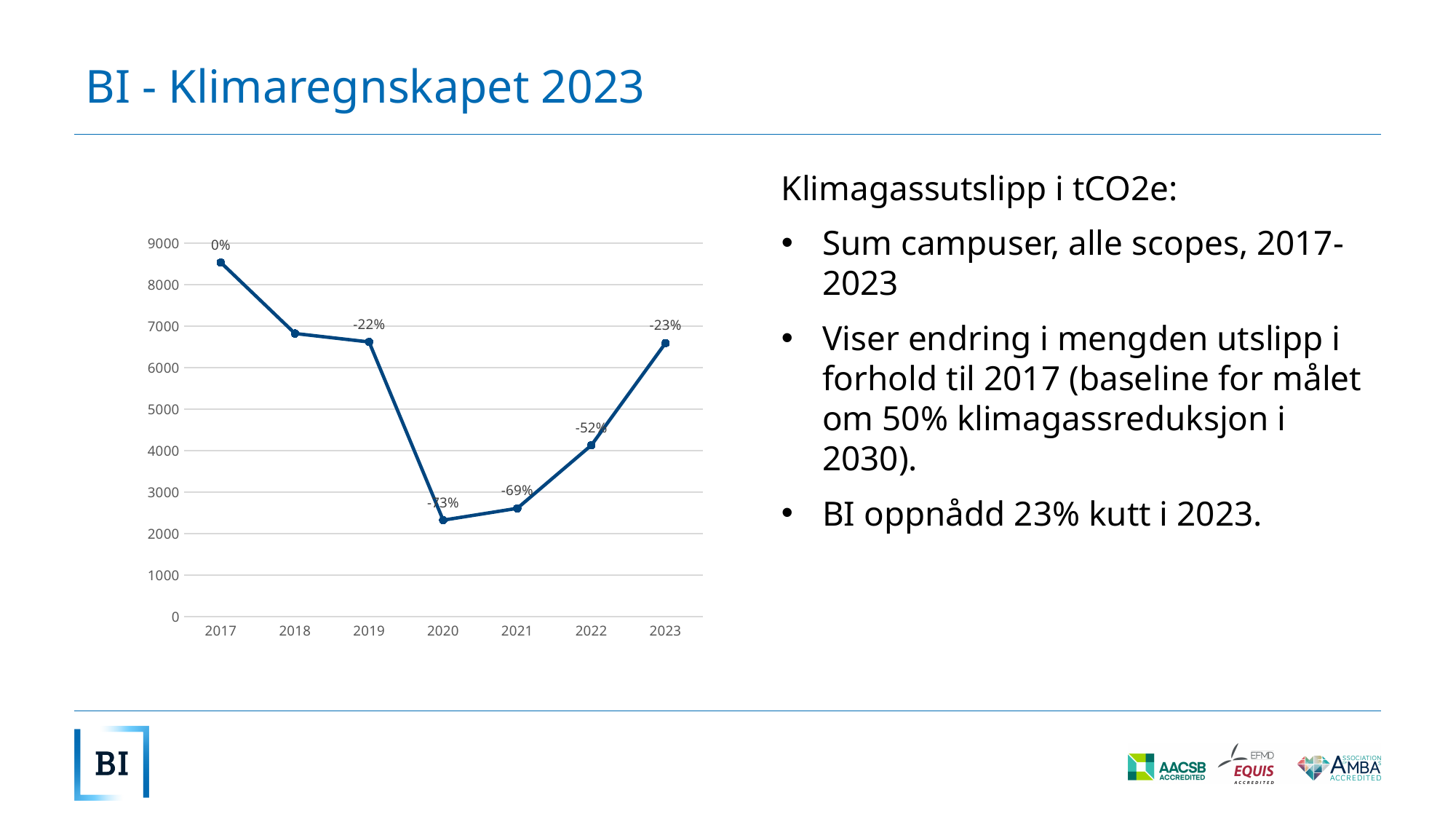
What is the data label shown for 2023? -23% What is the data label shown for 2019? -22% Is the emissions value for 2017 greater or less than 8000? greater How many years (data points) are plotted on the chart? 7 What is the data label shown for 2020? -73% What kind of chart is shown on the slide? line chart Which year has the highest emissions value on the chart? 2017 Which year has the larger emissions value, 2021 or 2022? 2022 Do the emissions values rise or fall from 2017 to 2020? fall Is the emissions value for 2020 greater or less than 3000? less Which year has the lowest emissions value on the chart? 2020 What is the data label shown for 2022? -52%